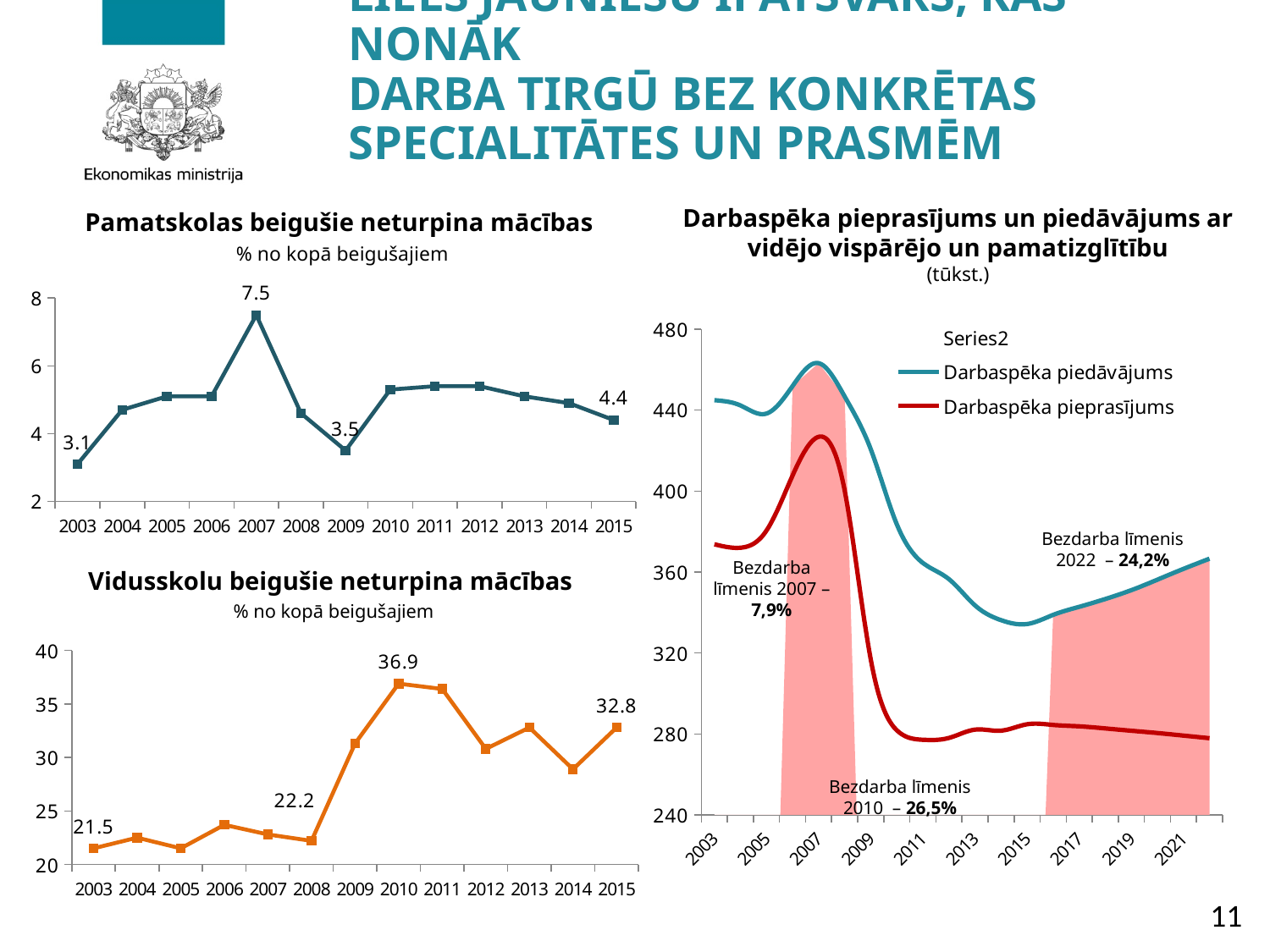
In the chart titled "Pamatskolas beigušie neturpina mācības", which year has the highest value? 2007 What kind of chart is the chart titled "Darbaspēka pieprasījums un piedāvājums ar vidējo vispārējo un pamatizglītību"? combination area and line chart In the chart titled "Darbaspēka pieprasījums un piedāvājums ar vidējo vispārējo un pamatizglītību", is the value of Darbaspēka piedāvājums in 2015 greater or less than 360? less In the chart titled "Pamatskolas beigušie neturpina mācības", how many years are plotted on the x axis? 13 In the chart titled "Darbaspēka pieprasījums un piedāvājums ar vidējo vispārējo un pamatizglītību", how many entries does the legend list? 3 In the chart titled "Pamatskolas beigušie neturpina mācības", what is the value for 2007? 7.5 In the chart titled "Vidusskolu beigušie neturpina mācības", what is the value for 2015? 32.8 In the chart titled "Pamatskolas beigušie neturpina mācības", what is the difference between the 2007 value and the 2015 value? 3.1 In the chart titled "Vidusskolu beigušie neturpina mācības", which is larger: the value for 2008 or the value for 2010? 2010 In the chart titled "Vidusskolu beigušie neturpina mācības", what is the difference between the 2015 value and the 2003 value? 11.3 In the chart titled "Pamatskolas beigušie neturpina mācības", what is the value for 2003? 3.1 In the chart titled "Vidusskolu beigušie neturpina mācības", what is the value for 2010? 36.9